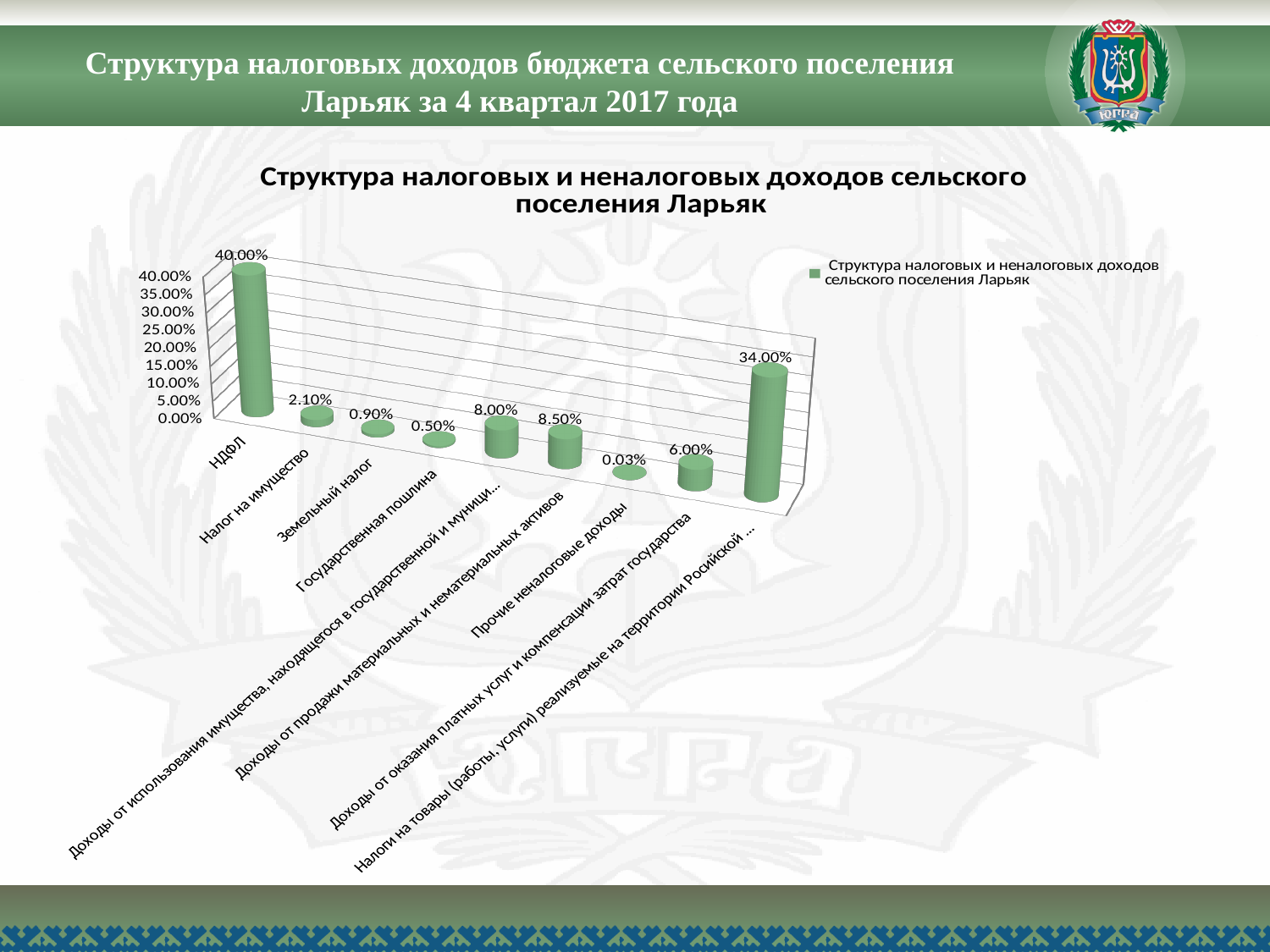
What is the value for Доходы от продажи материальных и нематериальных активов? 8.50% Which category has the lowest value? Прочие неналоговые доходы What is the title of the chart? Структура налоговых и неналоговых доходов сельского поселения Ларьяк Which category has the highest value? НДФЛ What is the value for Земельный налог? 0.90% What is the value for НДФЛ? 40.00% What is the value for Прочие неналоговые доходы? 0.03% What is the difference between the values for НДФЛ and Налоги на товары (работы, услуги) реализуемые на территории Росийской ...? 6.00% How many categories are shown on the x axis? 9 What kind of chart is shown? bar chart Is the value for Налоги на товары (работы, услуги) реализуемые на территории Росийской ... greater or less than 30.00%? greater Which is larger, the value for Налог на имущество or the value for Государственная пошлина? Налог на имущество